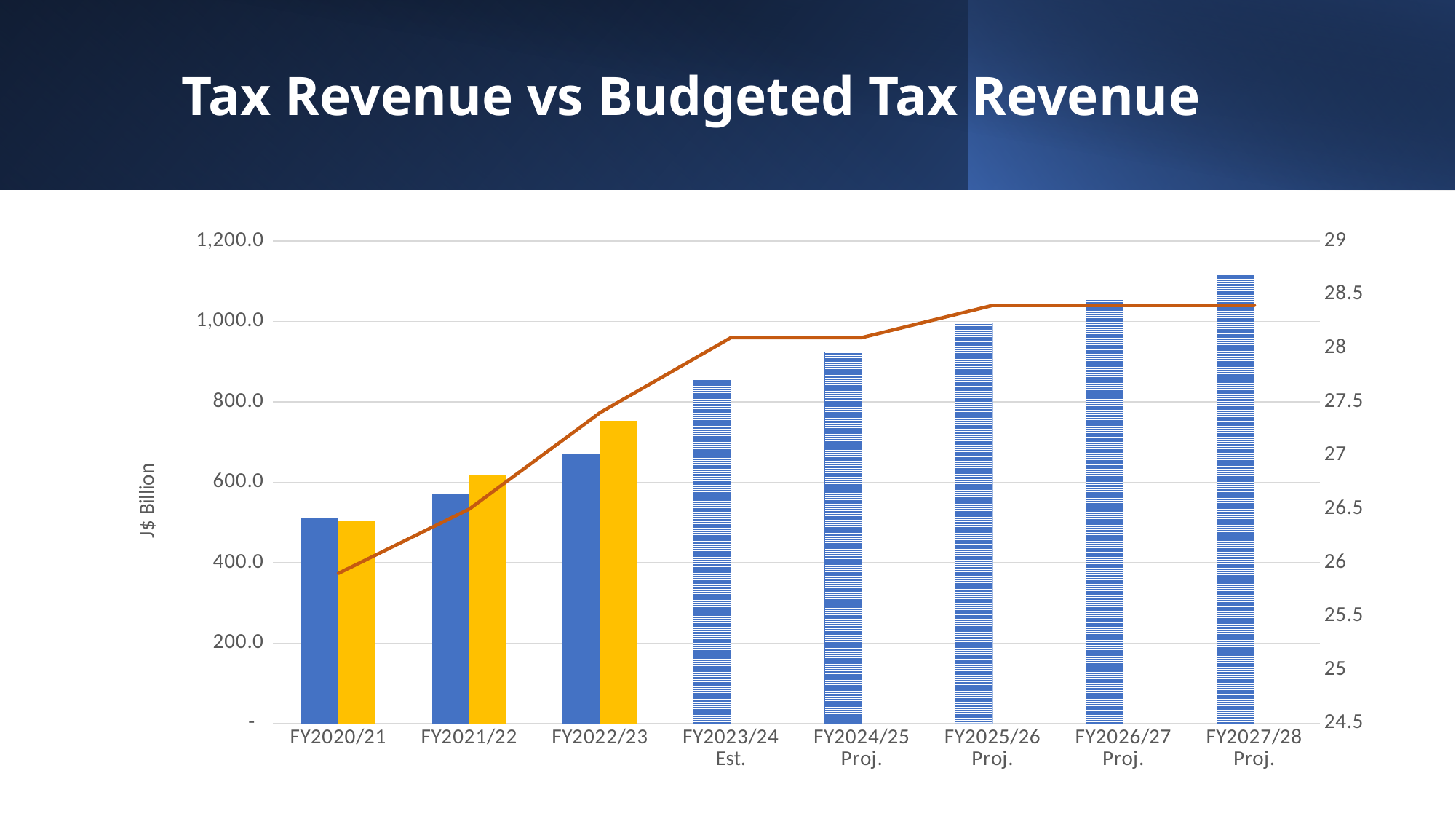
Is the yellow bar for FY2022/23 greater or less than 800.0? less Do the bar values generally rise or fall from FY2020/21 to FY2027/28 Proj.? rise Which fiscal year has the tallest bar? FY2027/28 Proj. Which fiscal year has the shortest bars? FY2020/21 How many fiscal year categories are shown on the x axis? 8 Is the bar for FY2027/28 Proj. greater or less than 1,000.0? greater Is the bar for FY2023/24 Est. greater or less than 1,000.0? less What is the title of the chart? Tax Revenue vs Budgeted Tax Revenue For FY2022/23, which bar is taller, the blue bar or the yellow bar? the yellow bar What is the label on the left vertical axis? J$ Billion What kind of chart is this? Bar chart with a line